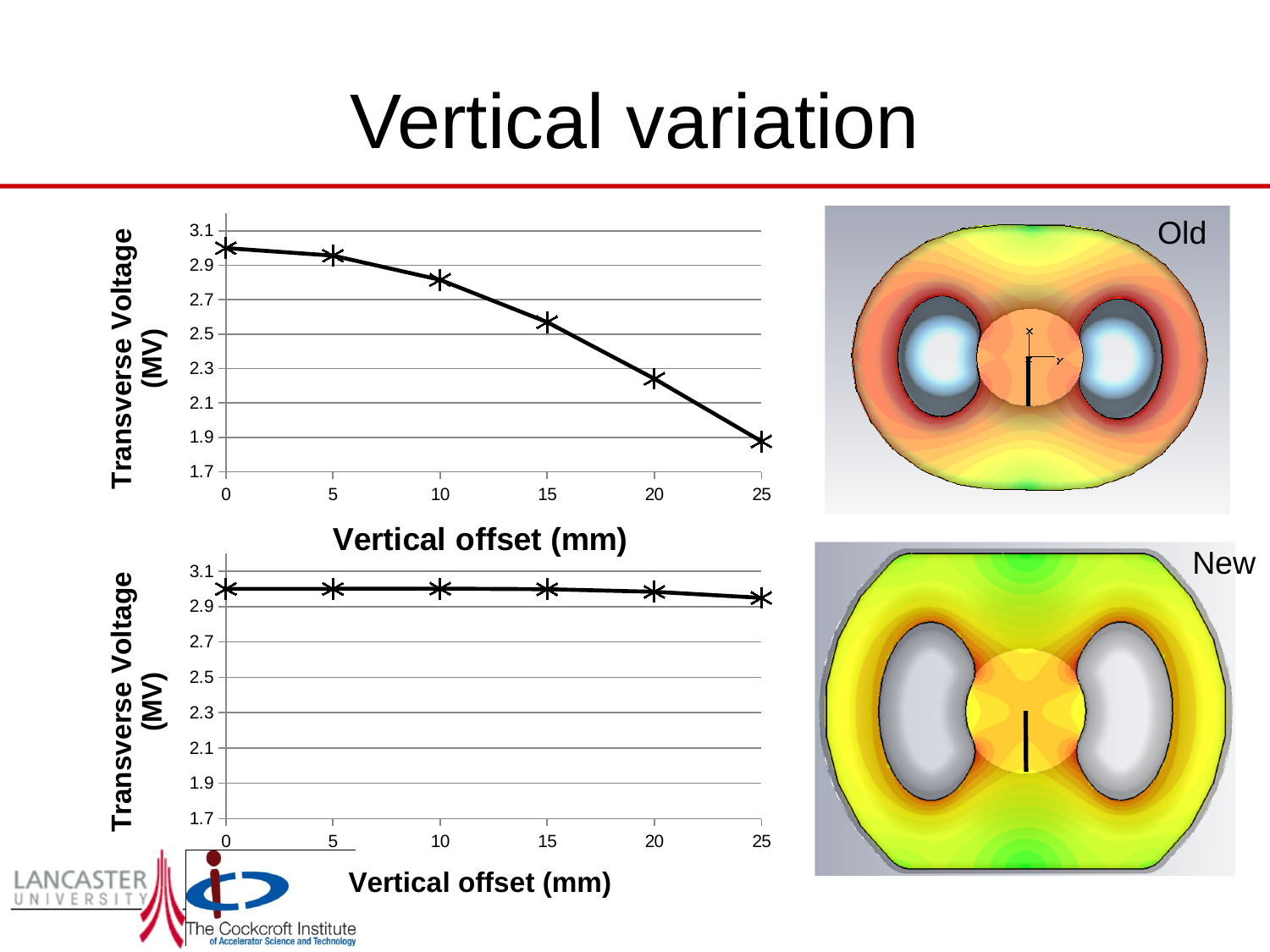
In the bottom chart, is the transverse voltage at a vertical offset of 25 mm greater or less than 2.7? greater How many data points are plotted in the top chart? 6 In the top chart, is the transverse voltage at a vertical offset of 20 mm greater or less than 2.3? less In the top chart, is the transverse voltage at a vertical offset of 15 mm greater or less than 2.5? greater What is the x-axis title of the bottom chart? Vertical offset (mm) What kind of chart is the top chart on the slide? line chart In the top chart, do the transverse voltage values rise or fall as the vertical offset increases? fall How many data points are plotted in the bottom chart? 6 In the top chart, at which vertical offset is the transverse voltage highest? 0 In the top chart, at which vertical offset is the transverse voltage lowest? 25 In the top chart, which has the larger transverse voltage: a vertical offset of 10 mm or 20 mm? 10 mm